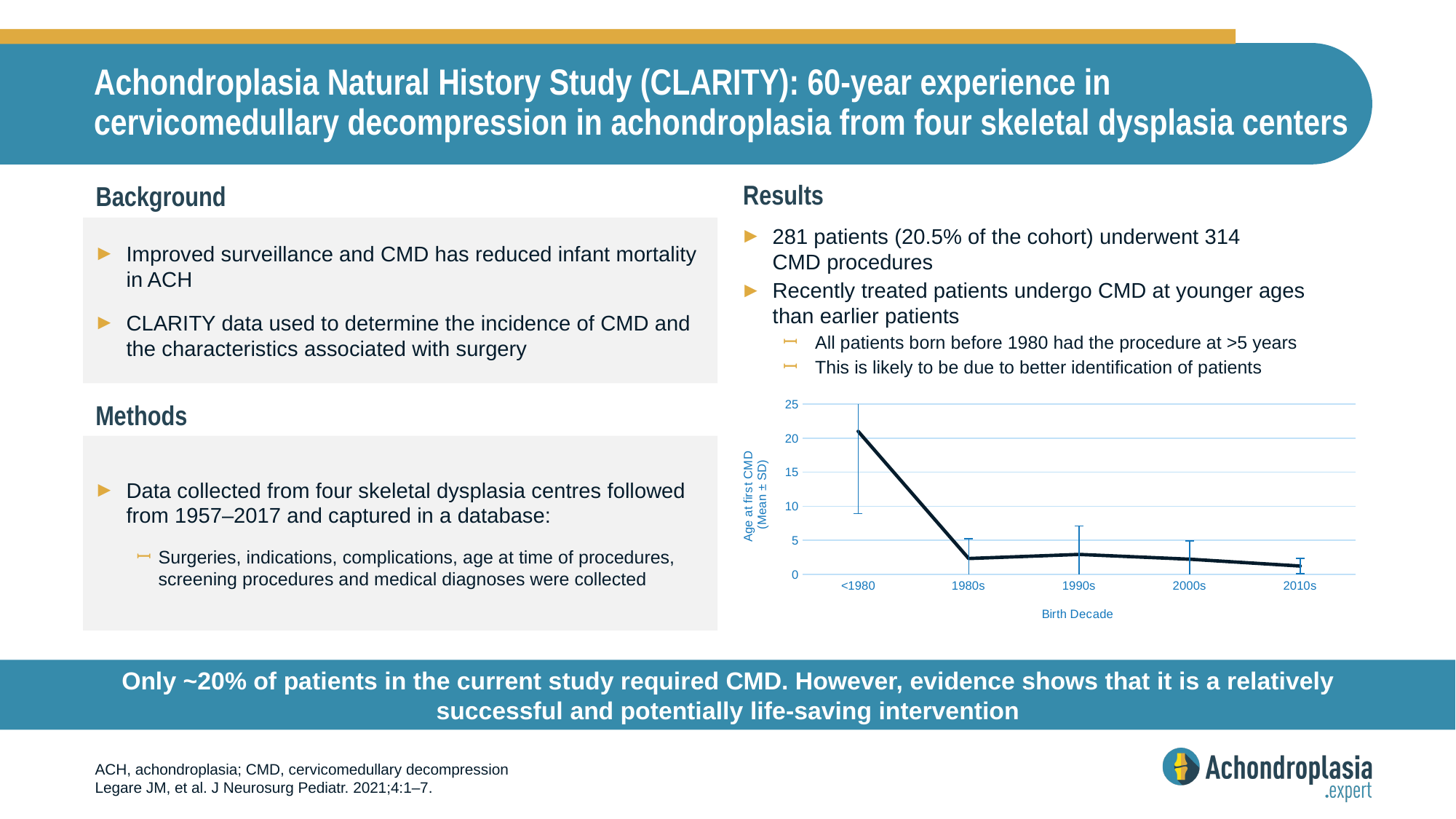
Does the mean age at first CMD rise or fall from the <1980 birth decade to the 2010s birth decade? fall Is the mean age at first CMD for the 1990s birth decade greater or less than 10? less Which birth decade has the lowest mean age at first CMD in the chart? 2010s Is the mean age at first CMD for the 1980s birth decade greater or less than 5? less What is the title of the x axis of the chart? Birth Decade Which birth decade has the highest mean age at first CMD in the chart? <1980 What is the highest value shown on the y axis of the chart? 25 Which has a higher mean age at first CMD: the <1980 birth decade or the 1980s birth decade? <1980 What kind of chart is shown on the slide? line chart Is the mean age at first CMD for patients born before 1980 greater or less than 15? greater What is the title of the y axis of the chart? Age at first CMD (Mean ± SD) How many birth decade categories are plotted on the x axis of the chart? 5